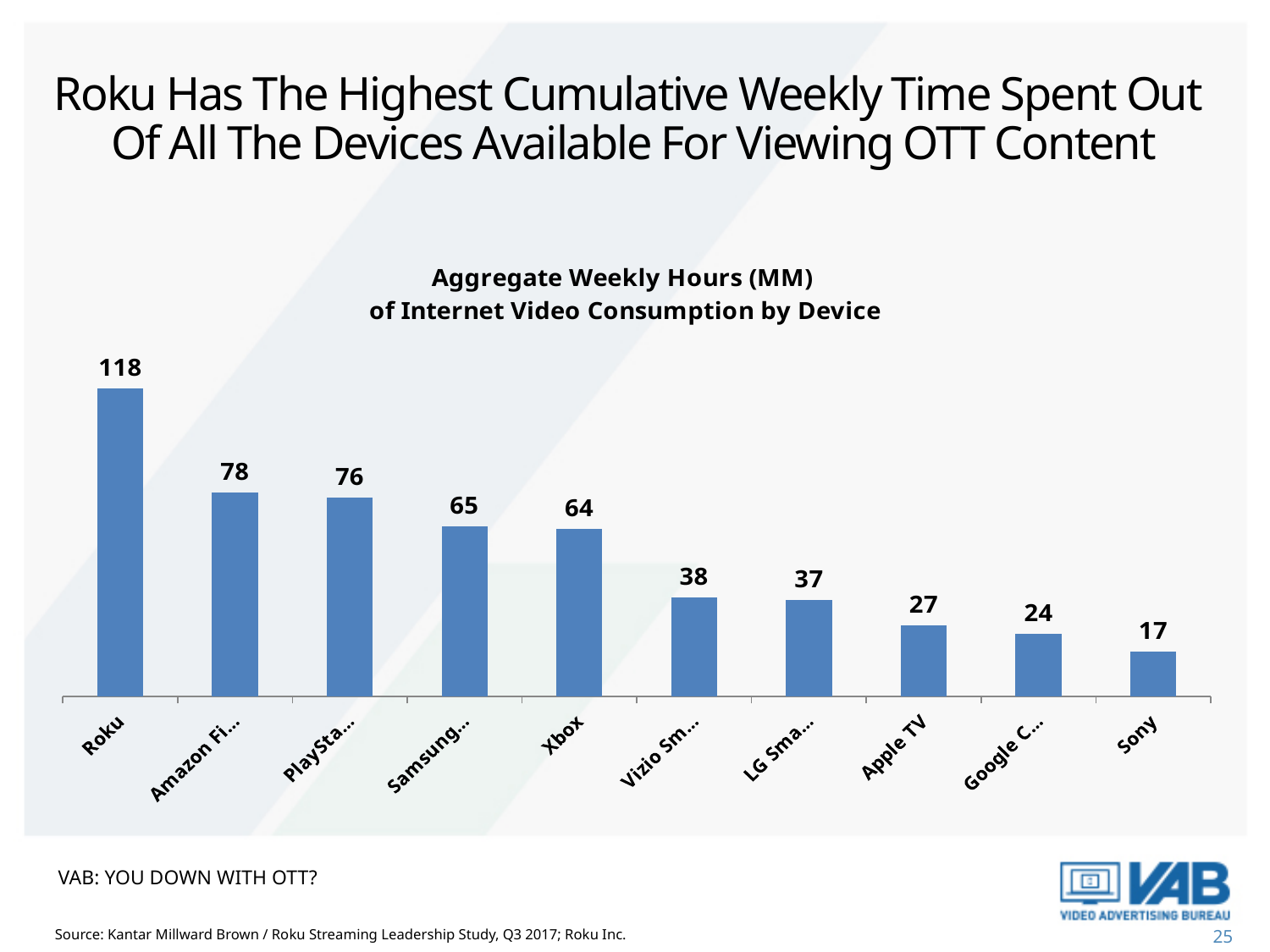
What is the value for Apple TV? 27 Which device has the highest aggregate weekly hours? Roku What is the value for Roku? 118 What is the value for Xbox? 64 Which is larger, the value for Xbox or the value for Apple TV? Xbox What is the title of the chart? Aggregate Weekly Hours (MM) of Internet Video Consumption by Device Which device has the lowest aggregate weekly hours? Sony What is the difference between the values for Apple TV and Sony? 10 What is the difference between the values for Roku and Xbox? 54 How many devices are shown in the chart? 10 What kind of chart is shown on the slide? bar chart What is the value for Sony? 17